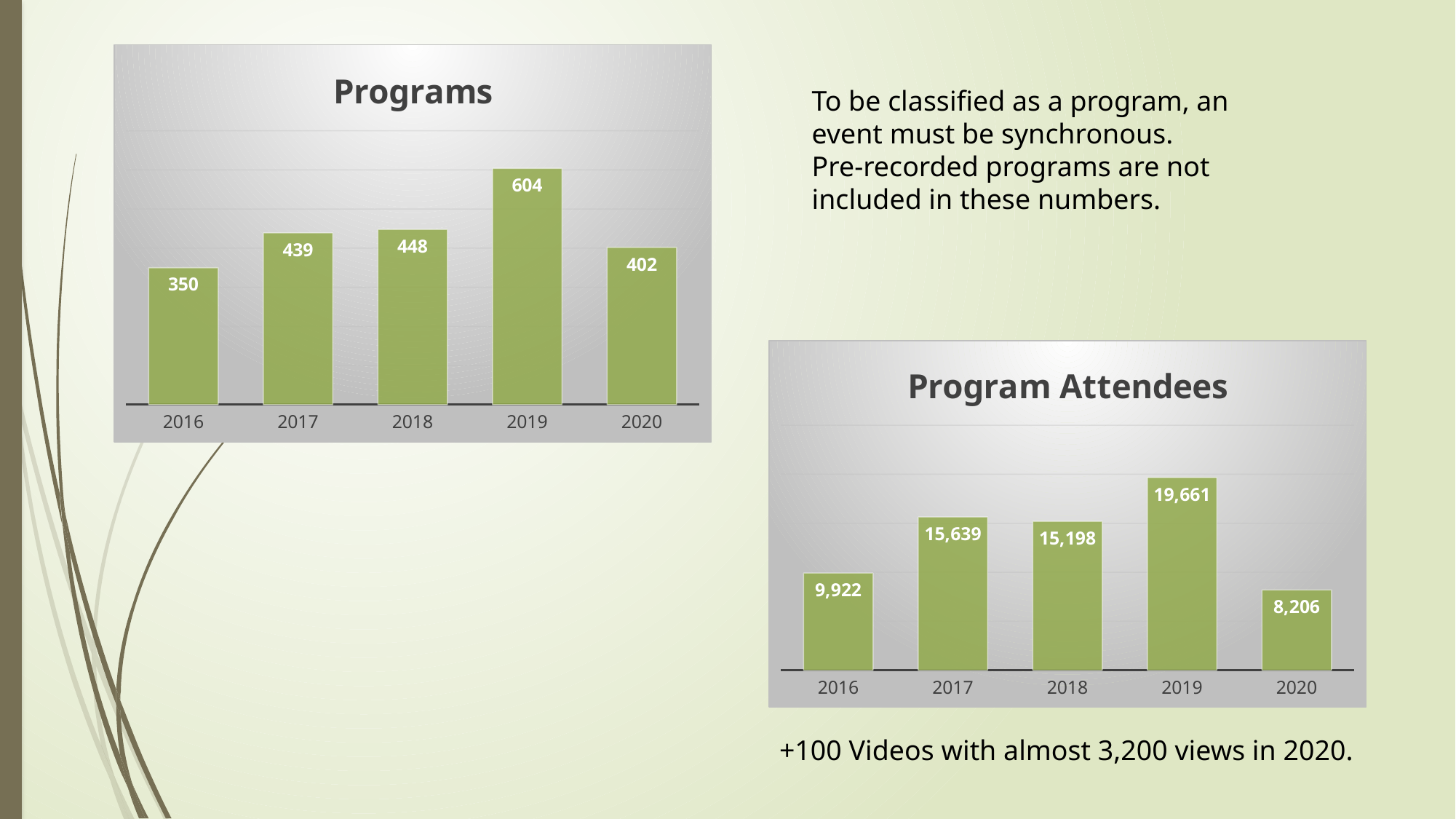
In the Programs chart, which year has the highest value? 2019 In the Programs chart, what is the difference between the values for 2019 and 2020? 202 In the Program Attendees chart, which year has the lowest value? 2020 In the Program Attendees chart, which is larger, the value for 2016 or the value for 2018? 2018 In the Program Attendees chart, what is the value for 2017? 15,639 In the Programs chart, what is the value for 2016? 350 In the Program Attendees chart, what is the value for 2020? 8,206 In the Program Attendees chart, what is the difference between the values for 2019 and 2016? 9,739 In the Programs chart, which year has the lowest value? 2016 In the Programs chart, how many years are shown on the x axis? 5 In the Programs chart, what is the value for 2019? 604 What kind of chart is the Program Attendees chart? Bar chart